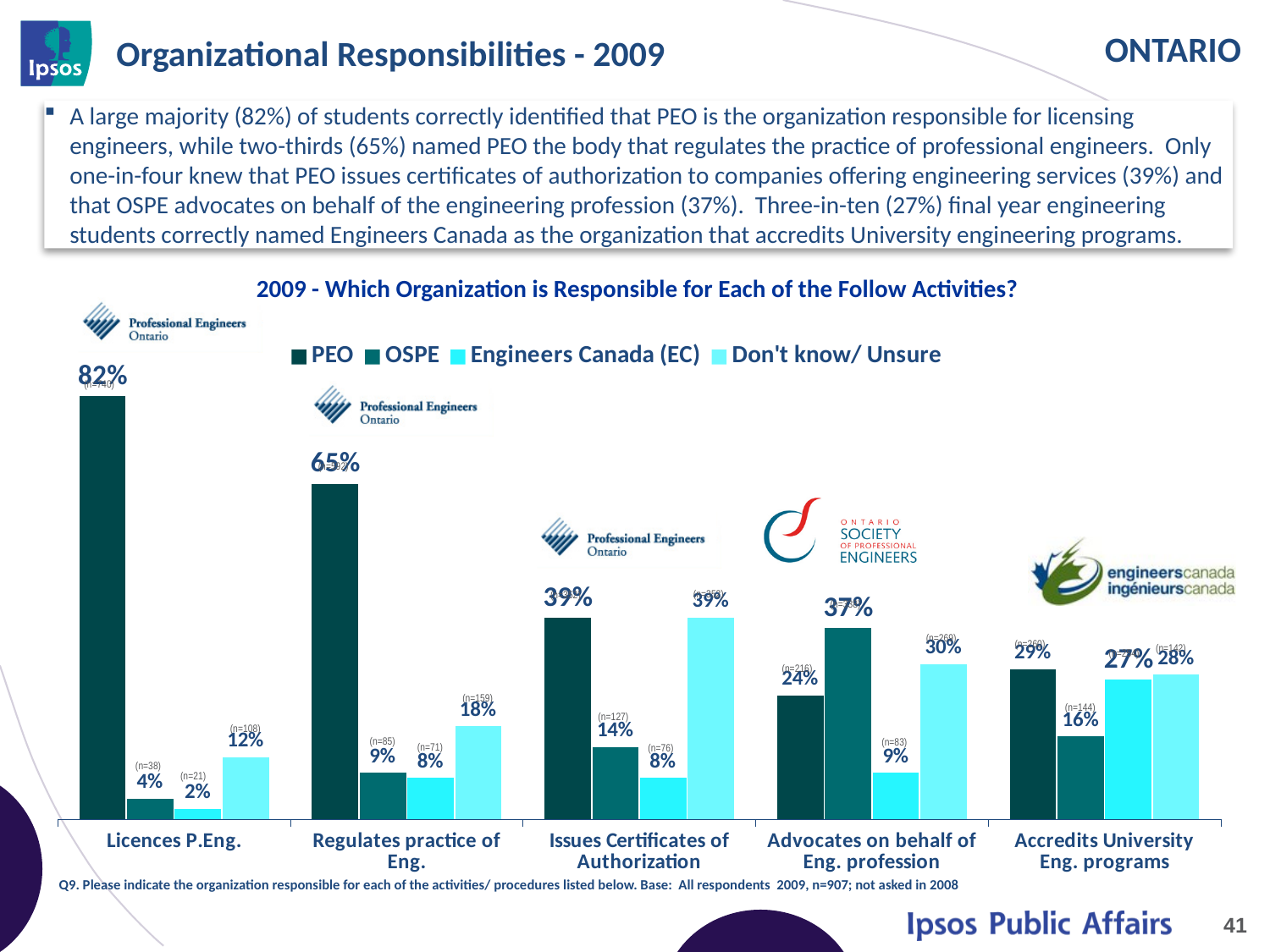
How many activities (categories) are shown on the x axis? 5 What is the title of the chart? 2009 - Which Organization is Responsible for Each of the Follow Activities? What percentage of students named PEO as responsible for licensing P.Eng.? 82% What kind of chart is shown on the slide? Bar chart Which activity has the lowest Engineers Canada (EC) value? Licences P.Eng. How many series does the legend list? 4 What is the OSPE value for 'Advocates on behalf of Eng. profession'? 37% For 'Advocates on behalf of Eng. profession', which is larger: the PEO value or the OSPE value? OSPE What is the 'Don't know/ Unsure' value for 'Regulates practice of Eng.'? 18% What is the Engineers Canada (EC) value for 'Accredits University Eng. programs'? 27% What is the difference between the PEO values for 'Licences P.Eng.' and 'Regulates practice of Eng.'? 17% Which activity has the highest PEO value? Licences P.Eng.